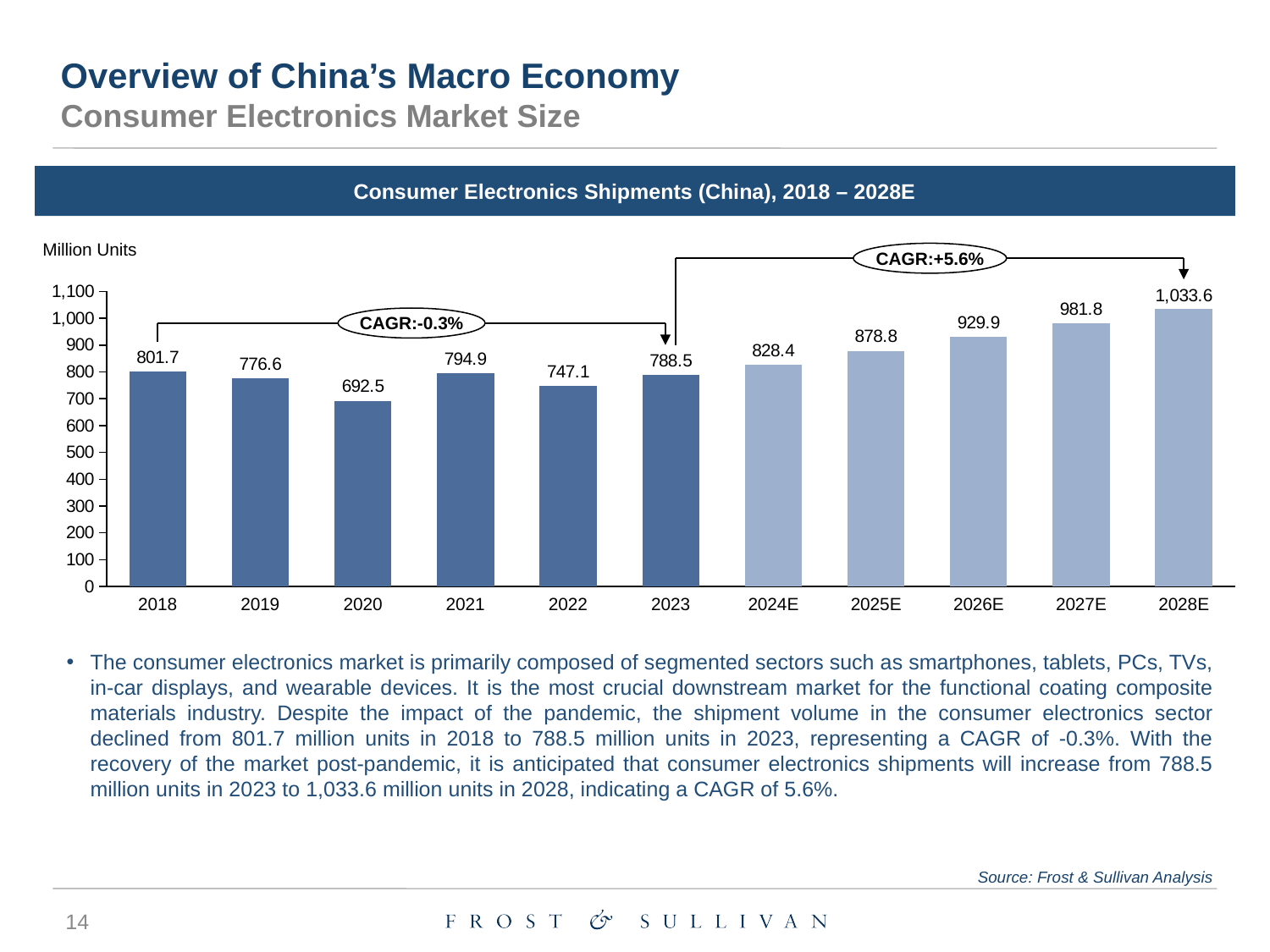
Which is larger, the value for 2019 or the value for 2021? 2021 What CAGR is shown for the period 2023 to 2028E? +5.6% Do the values rise or fall from 2023 to 2028E? rise What is the value for 2020? 692.5 What is the title of the chart? Consumer Electronics Shipments (China), 2018 – 2028E Which year has the highest value? 2028E What kind of chart is this? bar chart What is the value for 2026E? 929.9 What is the difference between the values for 2028E and 2023? 245.1 Is the value for 2025E greater or less than 900? less Which year has the lowest value? 2020 How many years are shown on the x axis? 11